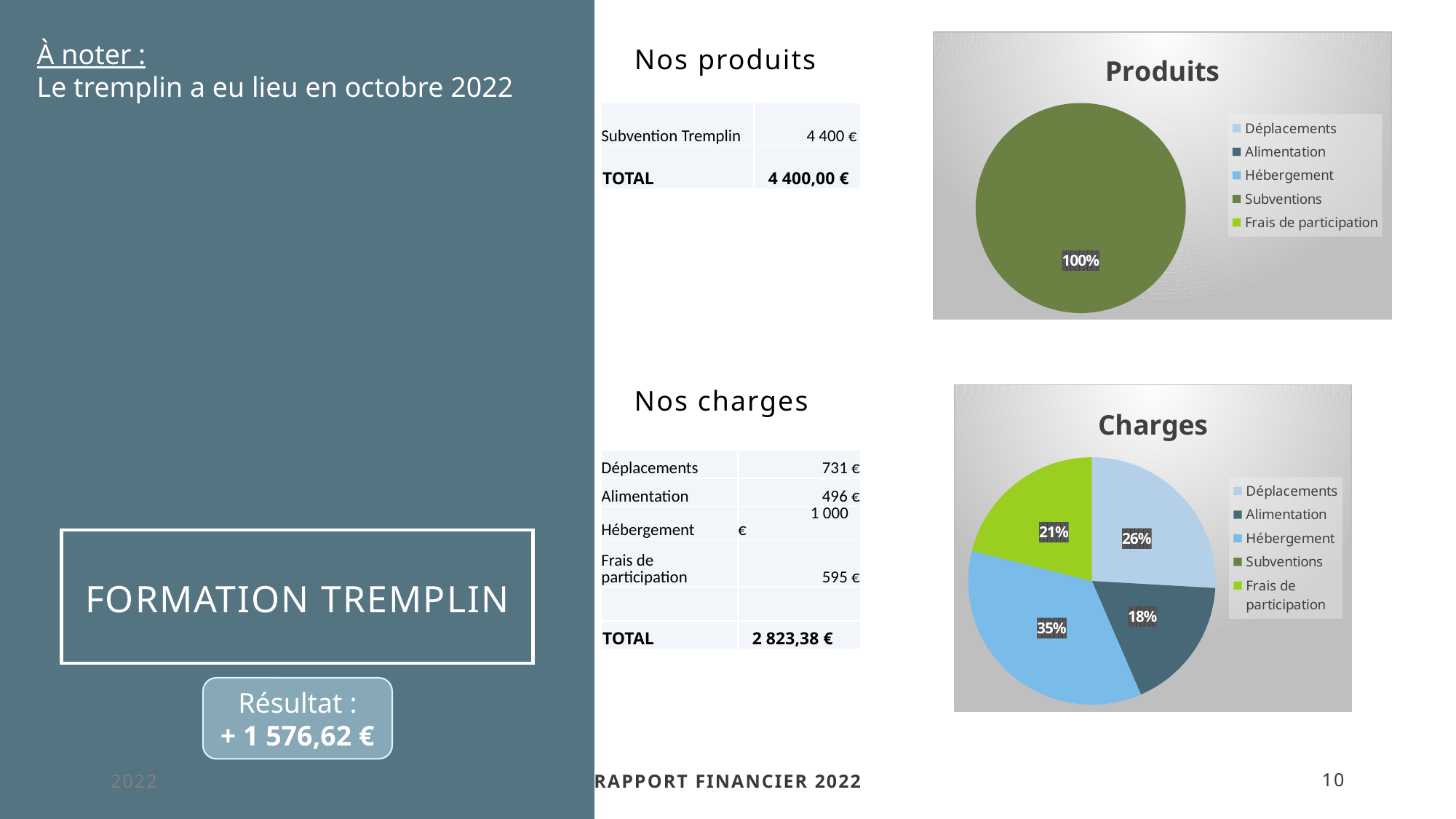
How many entries does the legend of the "Produits" pie chart list? 5 In the "Charges" pie chart, what share does Hébergement have? 35% In the "Charges" pie chart, what is the difference in percentage points between Hébergement and Alimentation? 17 In the "Charges" pie chart, which is larger, Déplacements or Frais de participation? Déplacements In the "Charges" pie chart, what share does Alimentation have? 18% What kind of chart is the "Charges" chart? pie chart In the "Charges" pie chart, what share does Déplacements have? 26% How many slices are visible in the "Charges" pie chart? 4 In the "Charges" pie chart, which category has the largest slice? Hébergement In the "Charges" pie chart, which category has the smallest slice? Alimentation